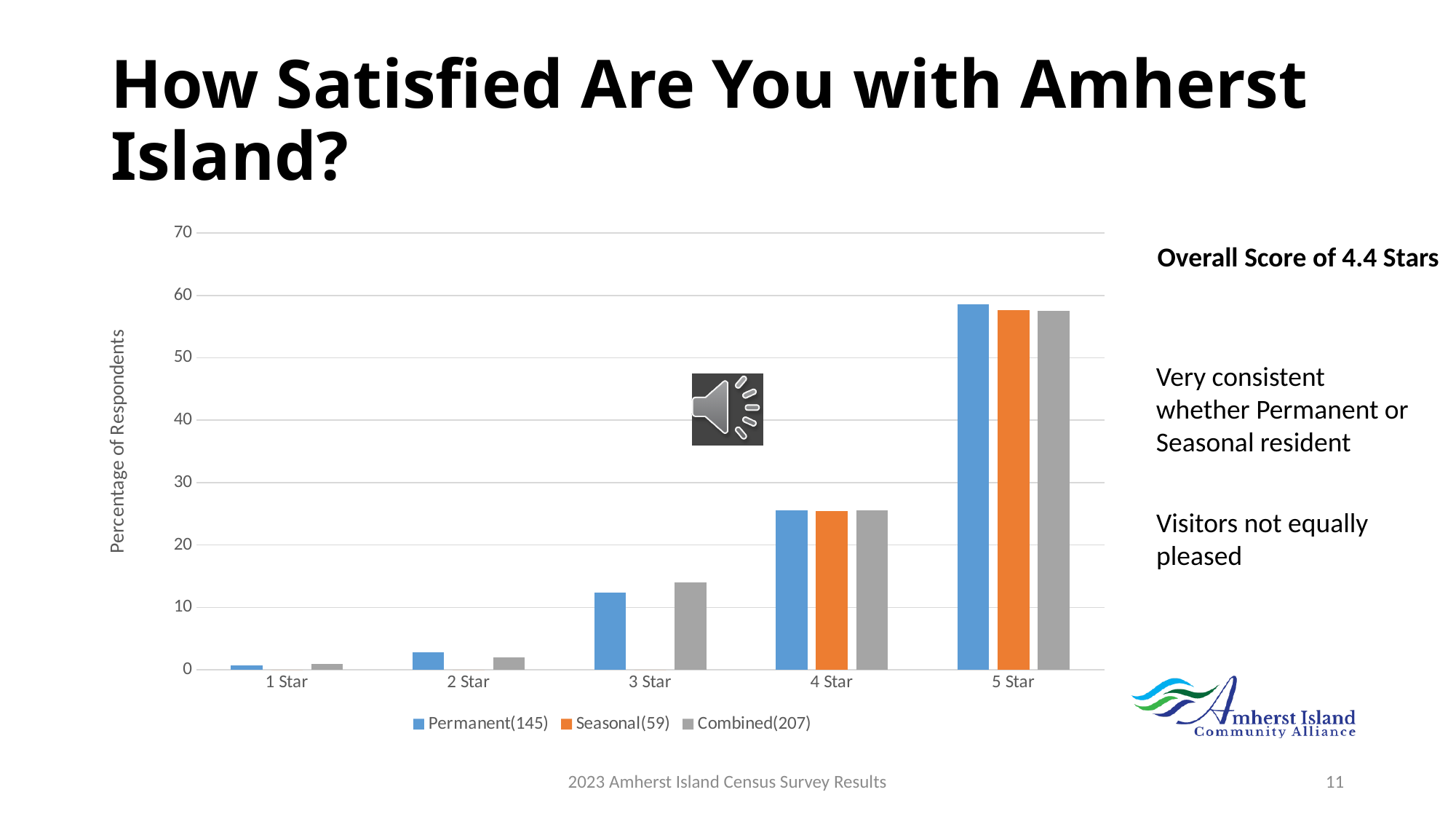
Which category has the highest value for the Permanent(145) series? 5 Star Which category has the highest value for the Combined(207) series? 5 Star Is the Seasonal(59) value for 5 Star greater or less than 60? less Do the Permanent(145) values rise or fall as the categories go from 1 Star to 5 Star? rise What kind of chart is shown on the slide? bar chart How many series does the chart's legend list? 3 Is the Permanent(145) value for 5 Star greater or less than 50? greater Is the Combined(207) value for 3 Star greater or less than 10? greater How many star-rating categories are shown on the x axis? 5 Which is larger for the Permanent(145) series: the value for 3 Star or the value for 4 Star? 4 Star Which category has the lowest value for the Permanent(145) series? 1 Star